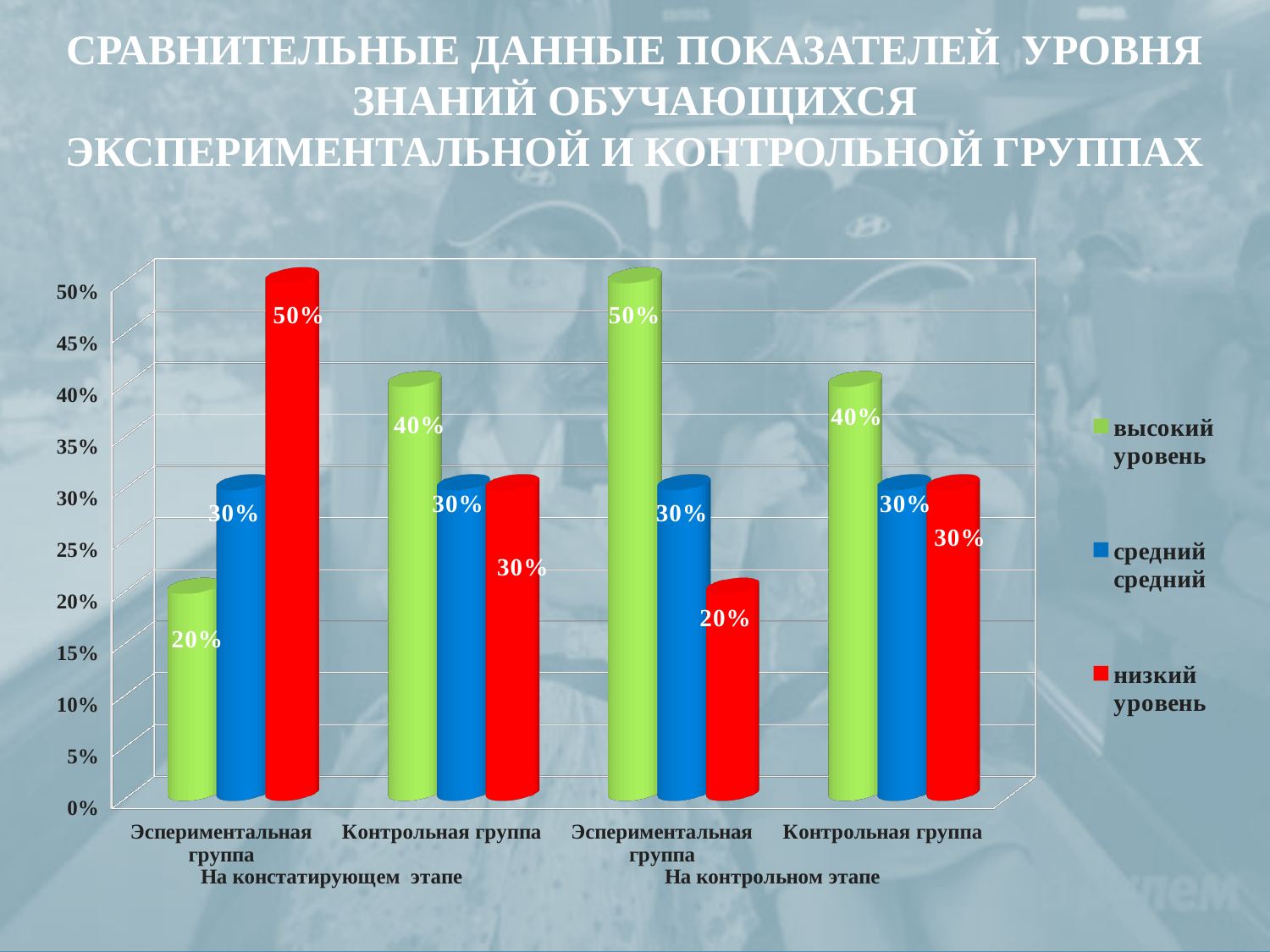
What is the value of the 'низкий уровень' series for the Экспериментальная группа at the констатирующий этап? 50% What colour represents the 'низкий уровень' series in the chart? red What is the value of the 'высокий уровень' series for the Экспериментальная группа at the констатирующий этап? 20% What is the difference between the 'высокий уровень' values for the Экспериментальная группа at the контрольный этап and at the констатирующий этап? 30% Which is larger for the Контрольная группа at the констатирующий этап: the 'высокий уровень' value or the 'средний' value? высокий уровень What is the value of the 'низкий уровень' series for the Контрольная группа at the контрольный этап? 30% How many category groups are shown along the x axis of the chart? 4 How many series does the chart legend list? 3 Which series has the lowest value for the Экспериментальная группа at the контрольный этап? низкий уровень Which series has the highest value for the Экспериментальная группа at the констатирующий этап? низкий уровень What is the value of the 'высокий уровень' series for the Экспериментальная группа at the контрольный этап? 50% What type of chart is shown on the slide? bar chart